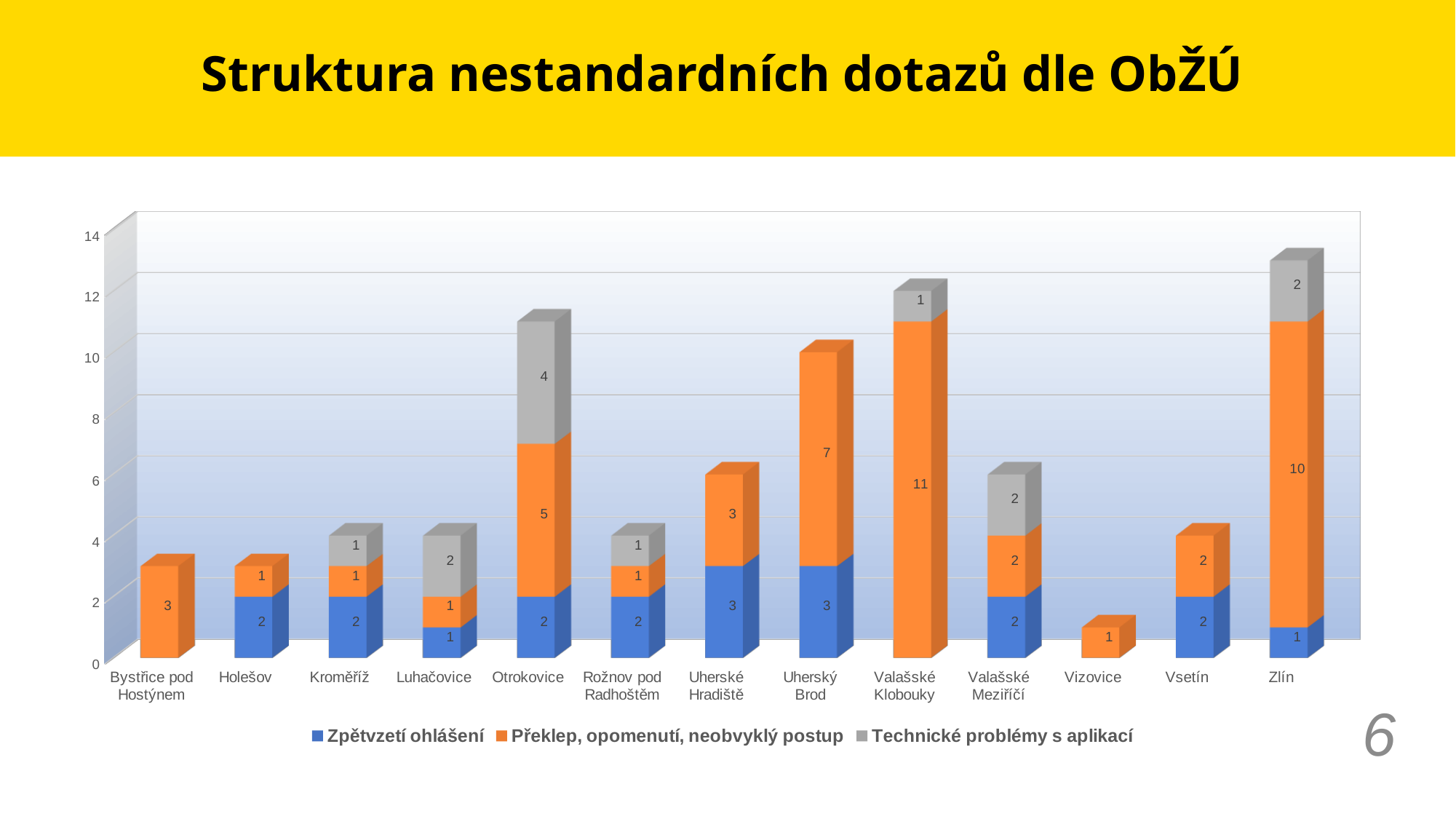
What kind of chart is shown on the slide? stacked bar chart What is the value of 'Technické problémy s aplikací' for Otrokovice? 4 How many series does the legend list? 3 Which category has the highest total stacked bar? Zlín What is the total of the stacked bar for Zlín? 13 Which is larger: the 'Technické problémy s aplikací' value for Luhačovice or for Kroměříž? Luhačovice What is the difference between the 'Překlep, opomenutí, neobvyklý postup' values for Valašské Klobouky and Uherský Brod? 4 How many categories (ObŽÚ) are shown on the x axis? 13 What is the total of the stacked bar for Otrokovice? 11 What is the value of 'Překlep, opomenutí, neobvyklý postup' for Zlín? 10 Which category has the lowest total stacked bar? Vizovice What is the value of 'Zpětvzetí ohlášení' for Uherské Hradiště? 3